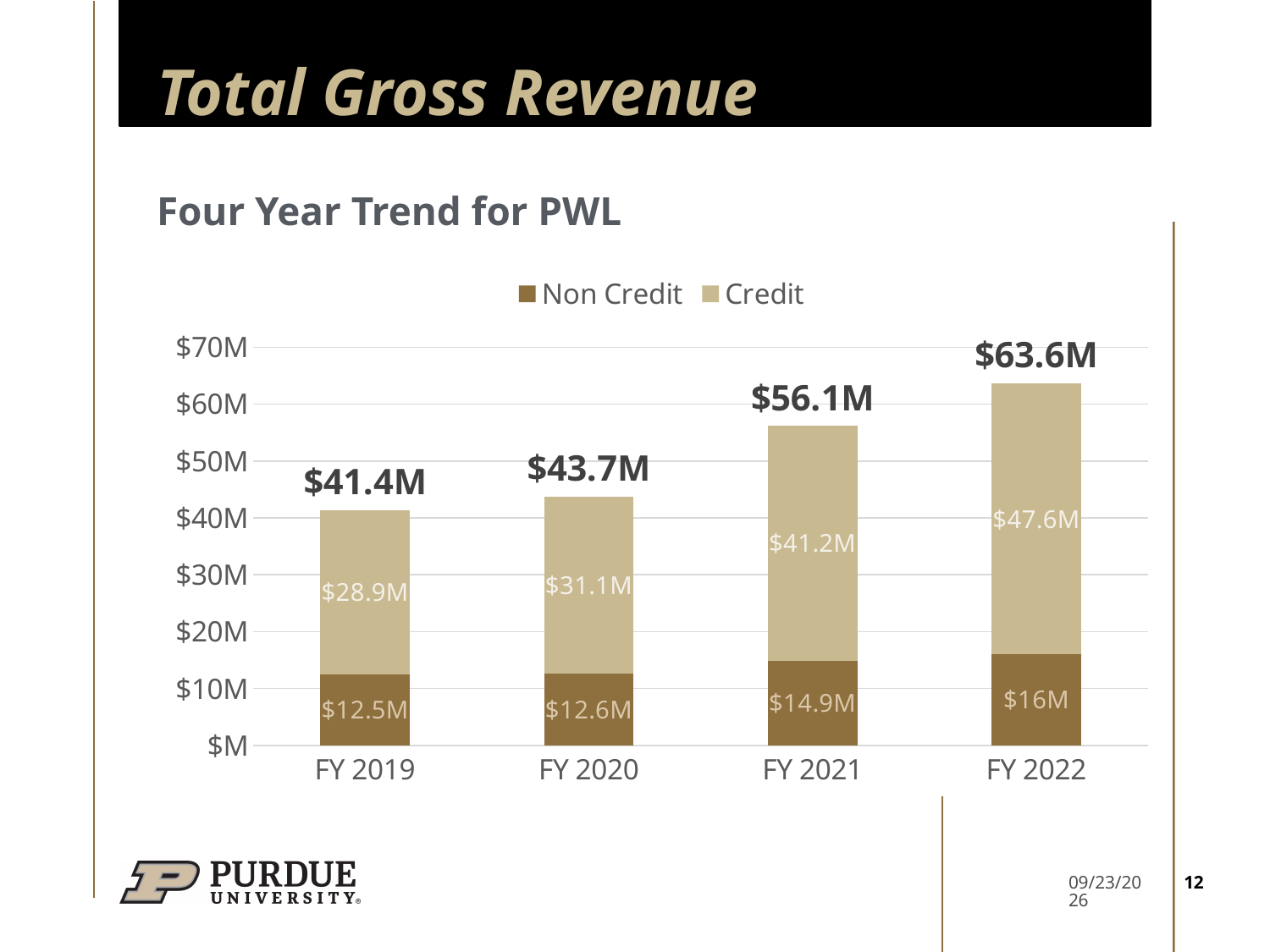
Do the total gross revenue values rise or fall from FY 2019 to FY 2022? Rise What kind of chart is shown on the slide? Stacked bar chart What is the Non Credit value for FY 2019? $12.5M Is the total for FY 2021 greater or less than $50M? greater What is the difference between the Credit values for FY 2022 and FY 2021? $6.4M Which fiscal year has the highest total gross revenue? FY 2022 How many fiscal years are shown on the x axis? 4 Which is larger, the Non Credit value for FY 2021 or for FY 2020? FY 2021 Which fiscal year has the lowest Non Credit value? FY 2019 How many series does the legend list? 2 What is the total gross revenue shown above the FY 2022 bar? $63.6M What is the Credit value for FY 2021? $41.2M